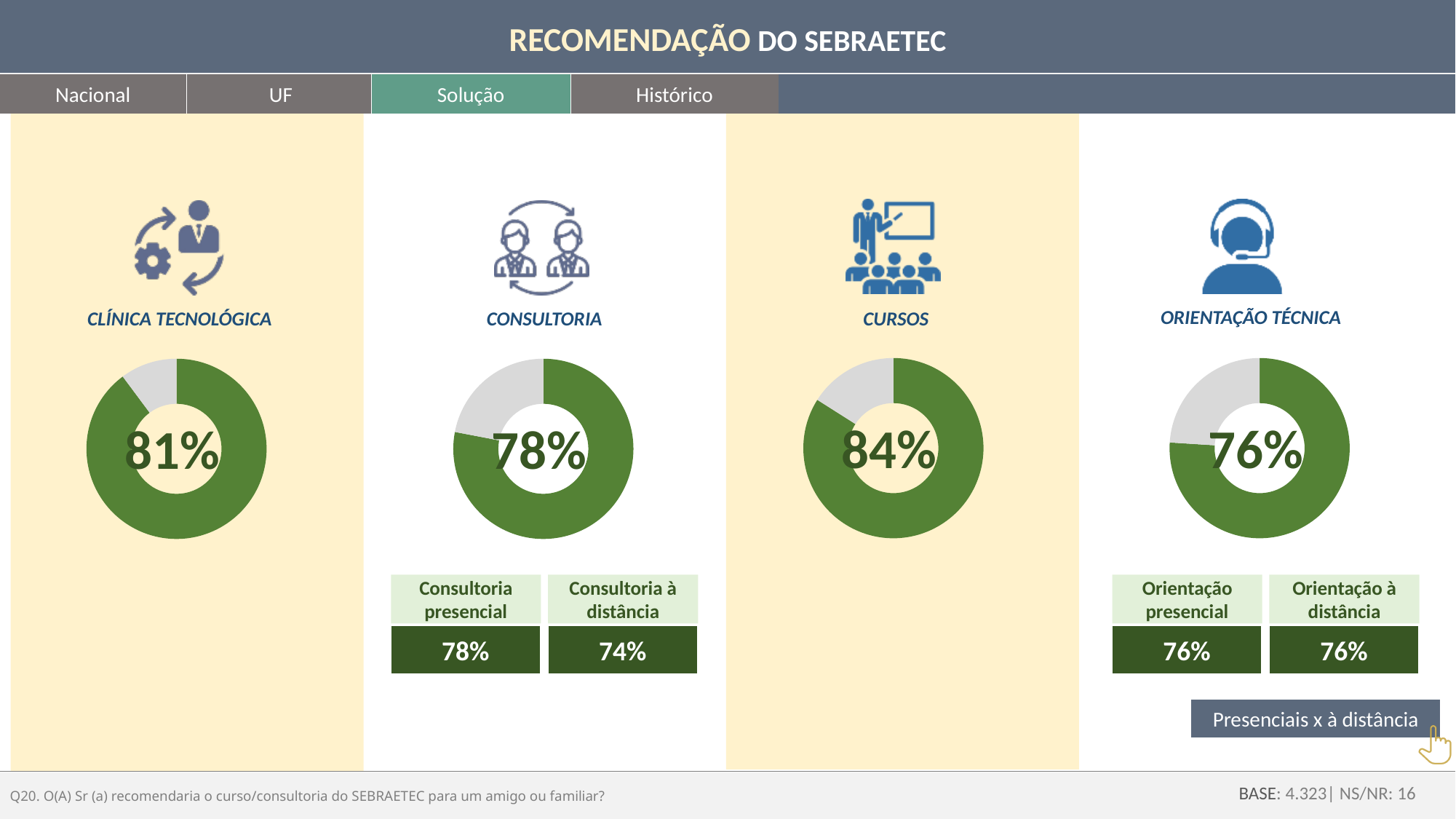
Which is larger, the CLÍNICA TECNOLÓGICA percentage or the CONSULTORIA percentage? CLÍNICA TECNOLÓGICA Under the ORIENTAÇÃO TÉCNICA chart, what is the value for Orientação presencial? 76% What percentage is shown in the CURSOS donut chart? 84% What percentage is shown in the ORIENTAÇÃO TÉCNICA donut chart? 76% What is the difference between the CURSOS percentage and the ORIENTAÇÃO TÉCNICA percentage? 8% What percentage is shown in the CONSULTORIA donut chart? 78% Which of the four solutions has the lowest recommendation percentage? ORIENTAÇÃO TÉCNICA Under the CONSULTORIA chart, what is the value for Consultoria à distância? 74% What percentage is shown in the CLÍNICA TECNOLÓGICA donut chart? 81% What kind of chart is used to display each solution's percentage? Donut chart Which of the four solutions has the highest recommendation percentage? CURSOS How many donut charts are shown on the slide? 4